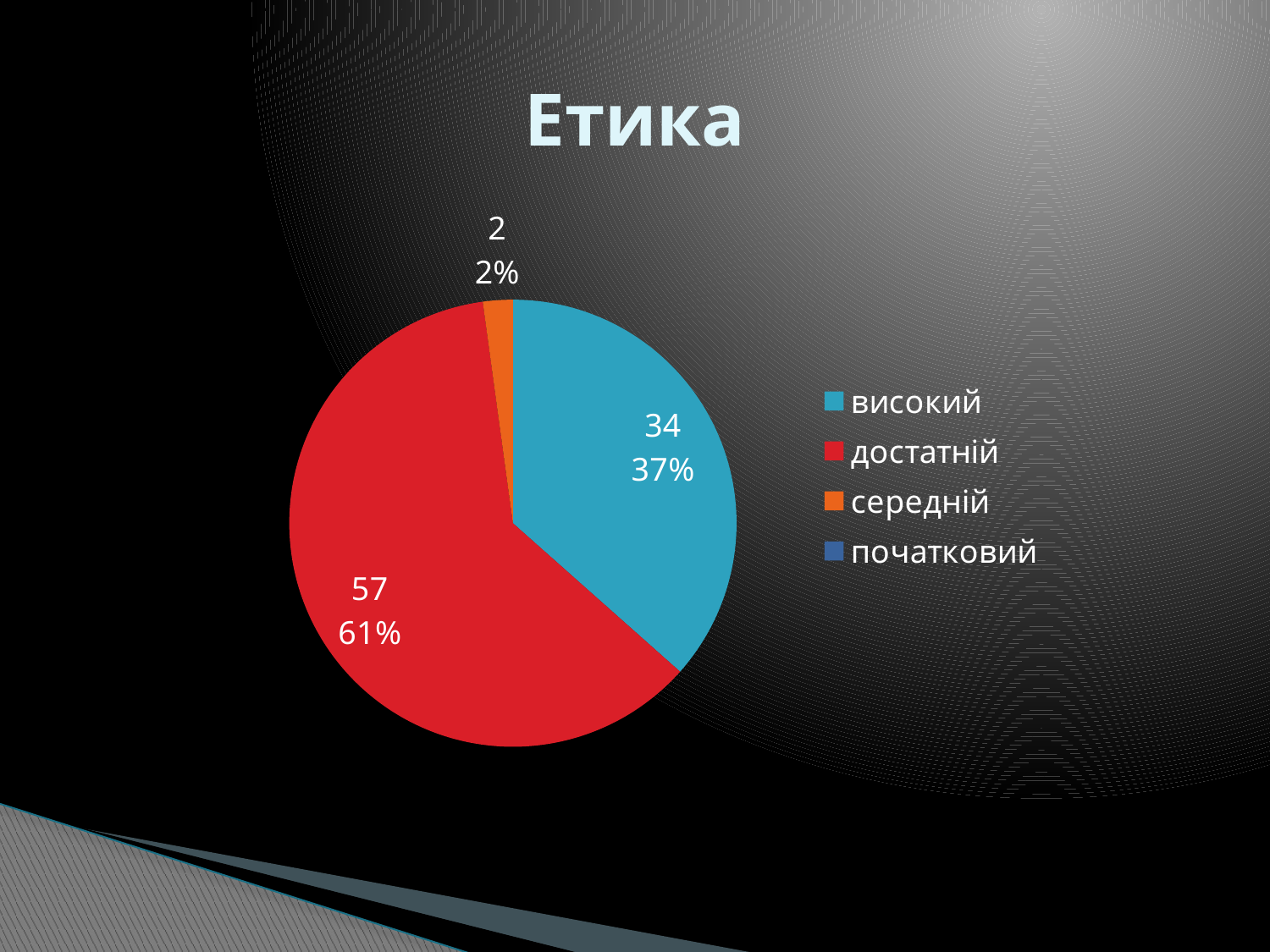
Which labelled category has the smallest slice? середній What share of the pie does високий take? 37% What is the title of the chart? Етика What value is shown for the category середній? 2 What share of the pie does достатній take? 61% What is the difference between the values for достатній and високий? 23 What value is shown for the category високий? 34 Which is larger, the value for високий or the value for середній? високий Which category has the largest slice? достатній What kind of chart is shown on the slide? pie chart What value is shown for the category достатній? 57 How many entries does the legend list? 4